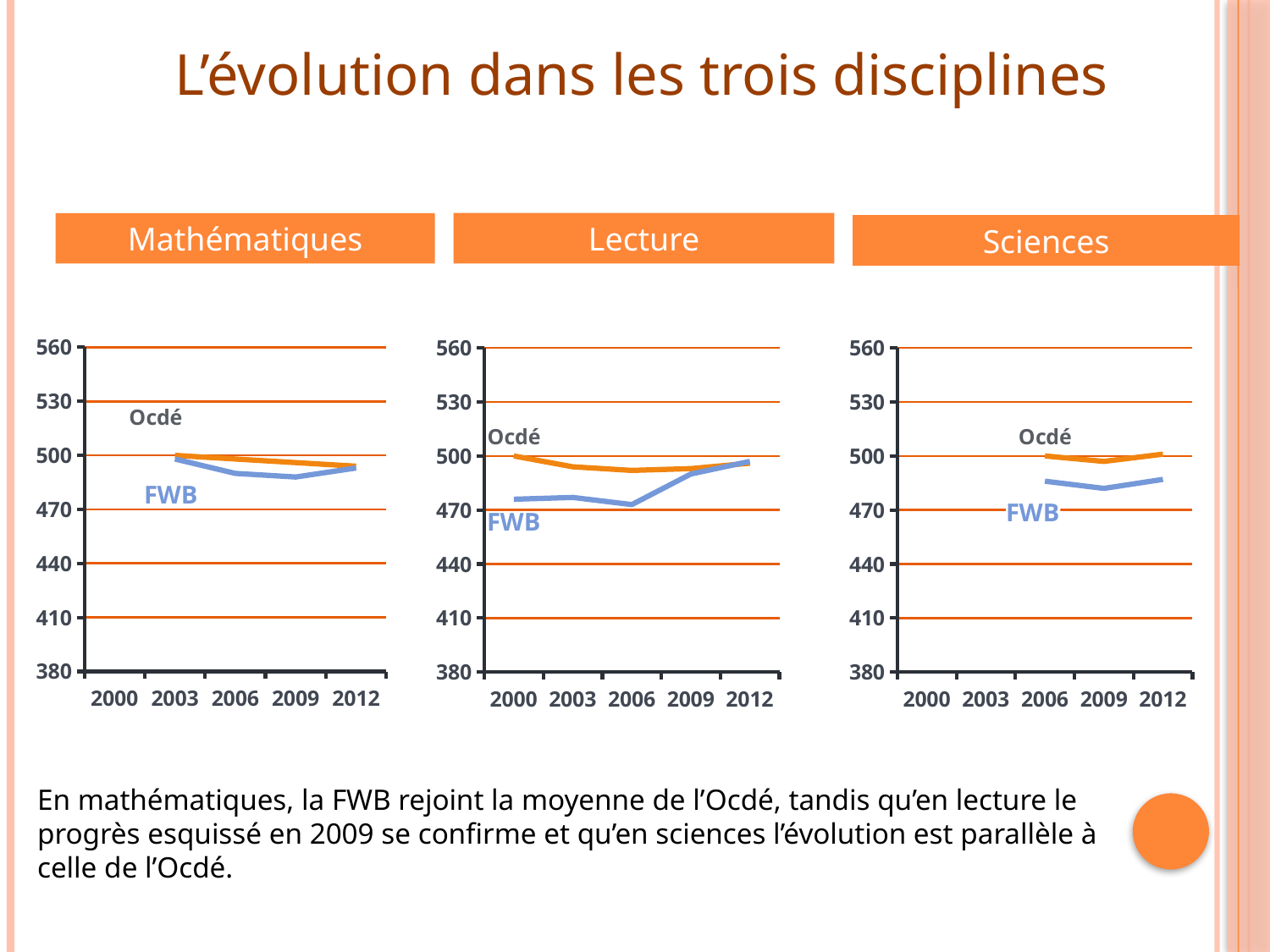
In the Sciences chart, which series has the higher value in 2009, Ocdé or FWB? Ocdé In the Lecture chart, is the FWB value for 2006 greater or less than 500? less In the Lecture chart, is the FWB value for 2000 greater or less than 470? greater What kind of chart is the Mathématiques chart? line chart In the Mathématiques chart, does the Ocdé line rise or fall between 2003 and 2012? fall In the Lecture chart, does the FWB line rise or fall between 2006 and 2012? rise How many series are plotted in the Lecture chart? 2 What colour is the FWB line in the three charts? blue In the Sciences chart, is the Ocdé value for 2012 greater or less than 530? less How many data points does the FWB line have in the Sciences chart? 3 In the Lecture chart, which series has the higher value in 2006, Ocdé or FWB? Ocdé